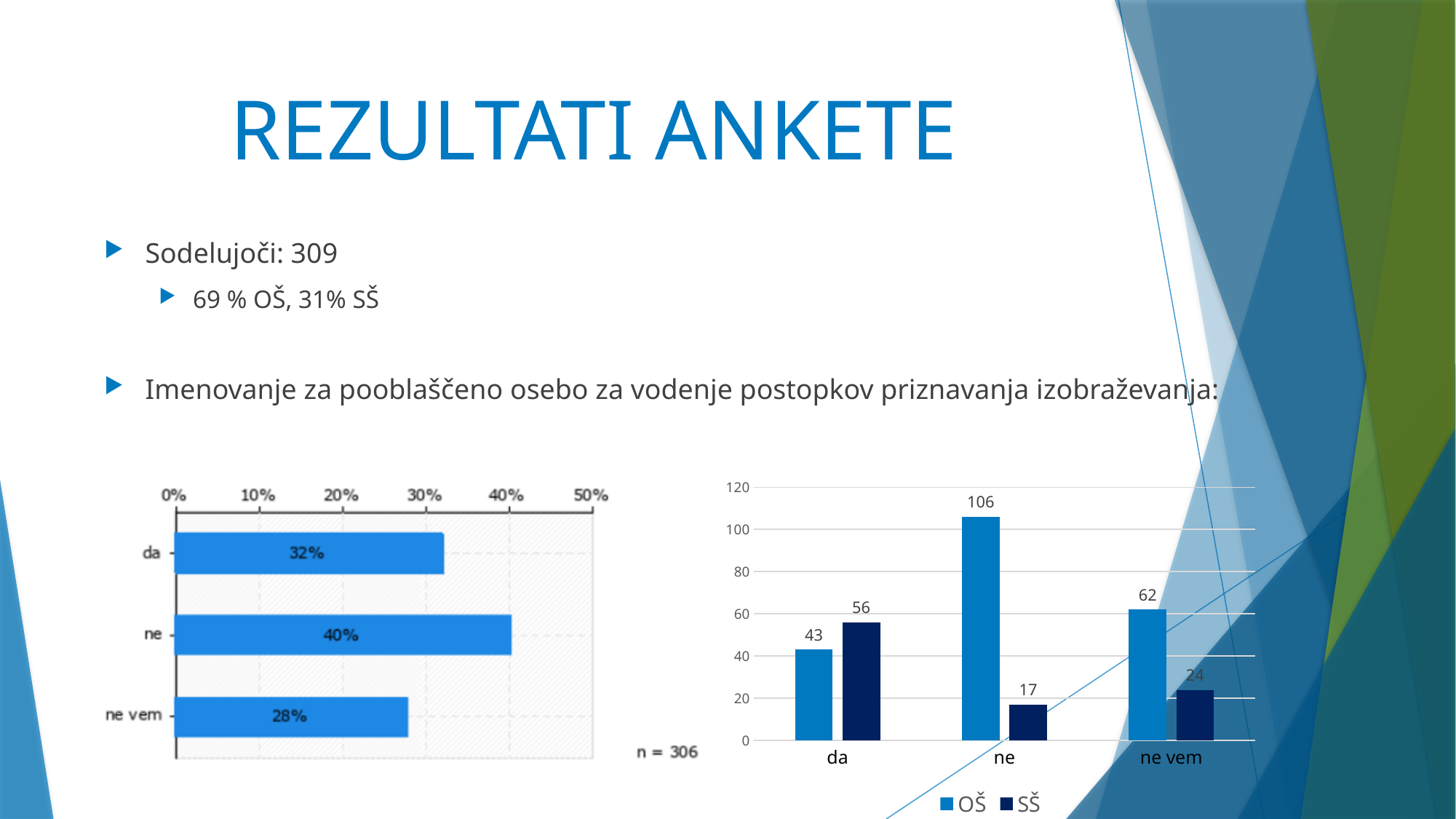
In the left chart, what is the value for "ne"? 40% In the right chart, what is the SŠ value for "da"? 56 In the right chart, how many series does the legend list? 2 In the left chart, what is the difference between the values for "ne" and "da"? 8% In the right chart, which is larger for "da": OŠ or SŠ? SŠ In the left chart, what sample size (n) is shown? n = 306 In the right chart, what is the OŠ value for "ne"? 106 In the right chart, which category has the highest OŠ value? ne In the left chart, which category has the lowest value? ne vem In the right chart, what is the difference between the OŠ and SŠ values for "ne vem"? 38 In the right chart, which category has the lowest SŠ value? ne In the left chart, how many categories are shown? 3